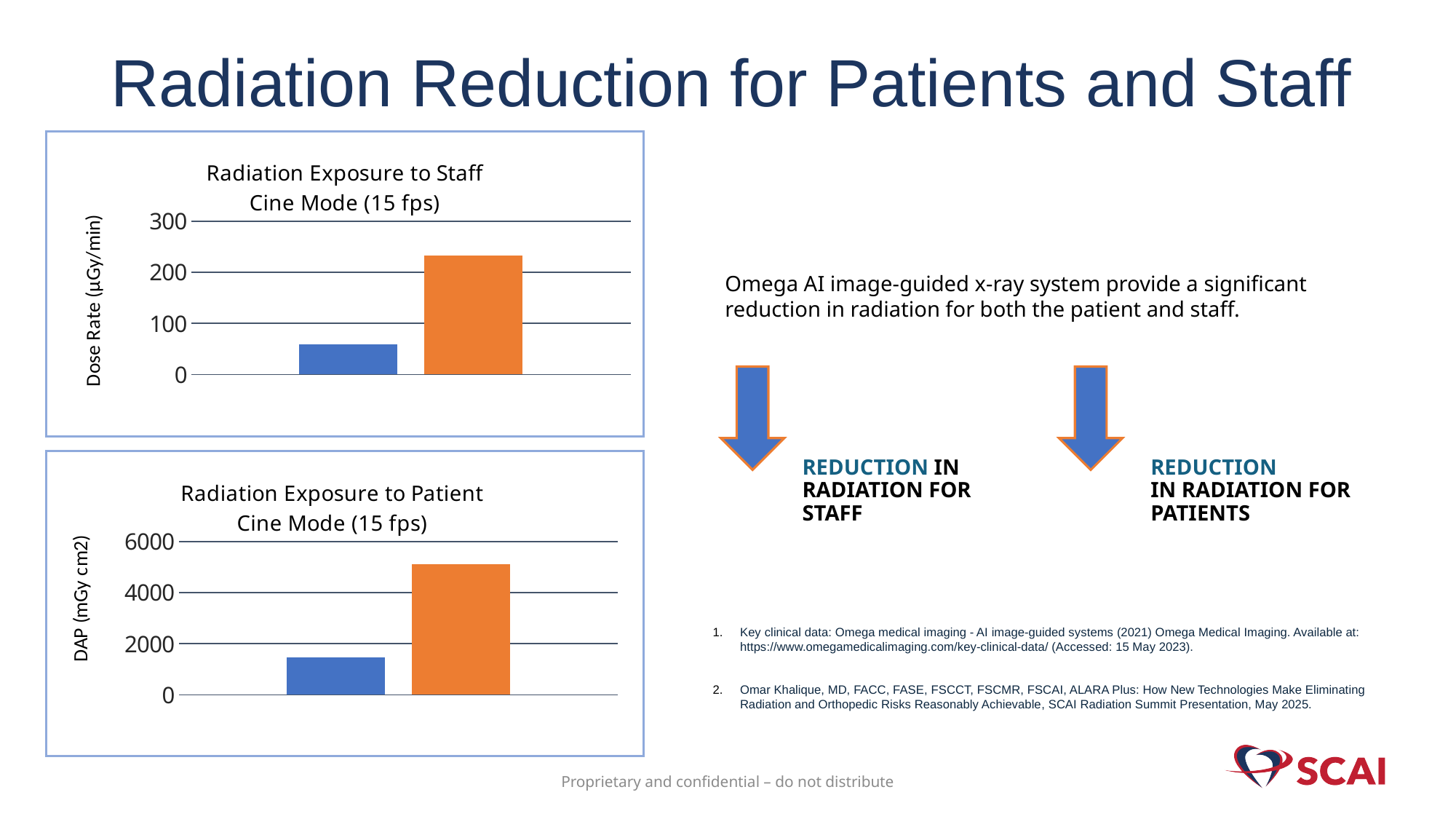
What is the y-axis label of the "Radiation Exposure to Patient Cine Mode (15 fps)" chart? DAP (mGy cm2) In the "Radiation Exposure to Staff Cine Mode (15 fps)" chart, which bar is taller, the blue bar or the orange bar? the orange bar In the "Radiation Exposure to Staff Cine Mode (15 fps)" chart, is the value of the blue bar greater or less than 100? less What is the y-axis label of the "Radiation Exposure to Staff Cine Mode (15 fps)" chart? Dose Rate (µGy/min) How many bars are plotted in the "Radiation Exposure to Patient Cine Mode (15 fps)" chart? 2 In the "Radiation Exposure to Patient Cine Mode (15 fps)" chart, is the value of the blue bar greater or less than 2000? less How many bars are plotted in the "Radiation Exposure to Staff Cine Mode (15 fps)" chart? 2 What kind of chart is the "Radiation Exposure to Patient Cine Mode (15 fps)" chart? bar chart In the "Radiation Exposure to Patient Cine Mode (15 fps)" chart, is the value of the orange bar greater or less than 4000? greater What kind of chart is the "Radiation Exposure to Staff Cine Mode (15 fps)" chart? bar chart In the "Radiation Exposure to Patient Cine Mode (15 fps)" chart, which bar is shorter, the blue bar or the orange bar? the blue bar